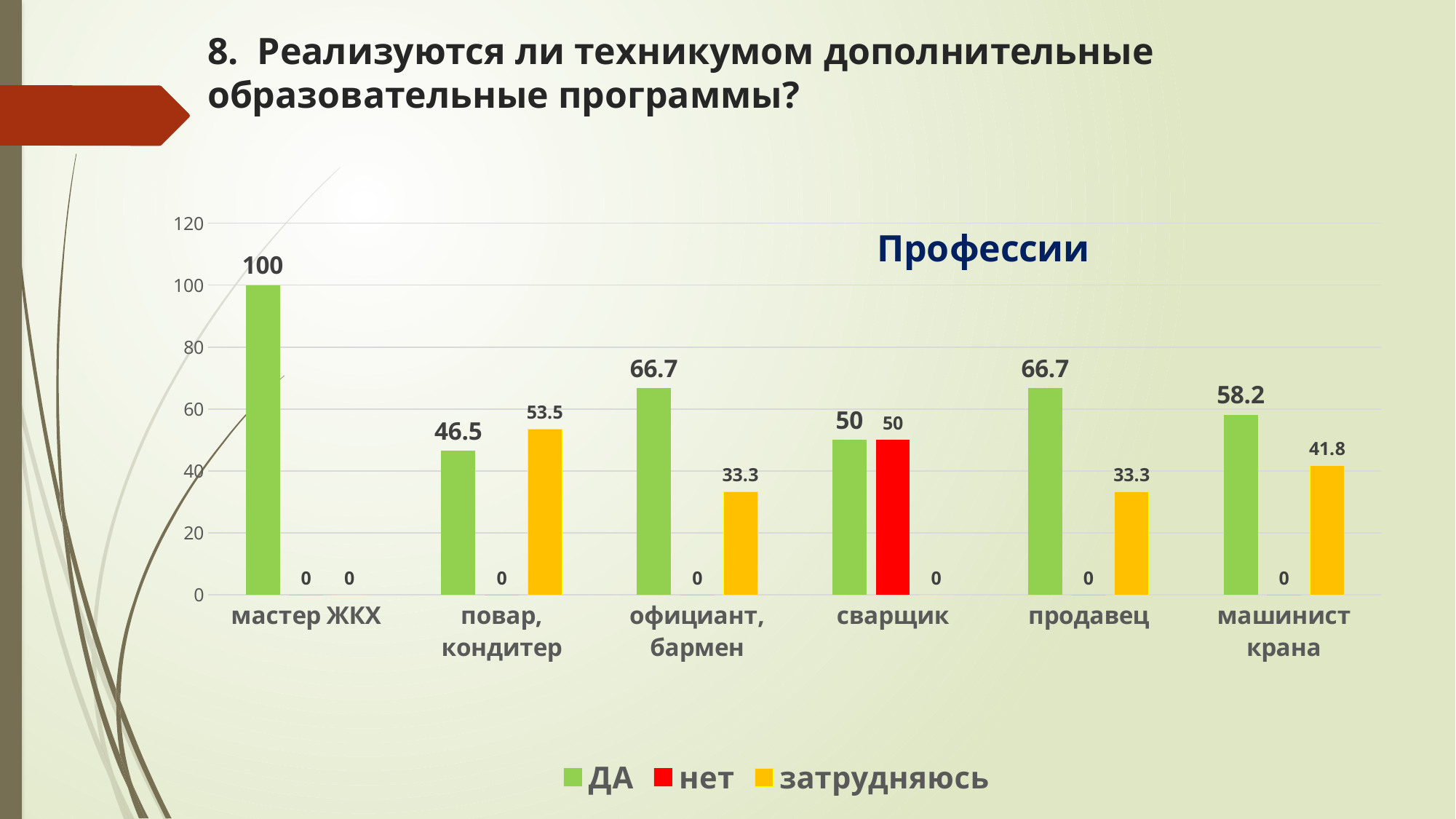
What kind of chart is shown on the slide? bar chart How many series does the legend list? 3 Which is larger: the ДА value for повар, кондитер or the затрудняюсь value for повар, кондитер? затрудняюсь What is the value of затрудняюсь for повар, кондитер? 53.5 What is the difference between the ДА value for официант, бармен and the ДА value for сварщик? 16.7 What colour represents the нет series? red How many categories are shown on the x axis? 6 What is the value of нет for сварщик? 50 What is the value of затрудняюсь for машинист крана? 41.8 Which category has the highest ДА value? мастер ЖКХ Which category has the lowest ДА value? повар, кондитер What is the value of ДА for мастер ЖКХ? 100